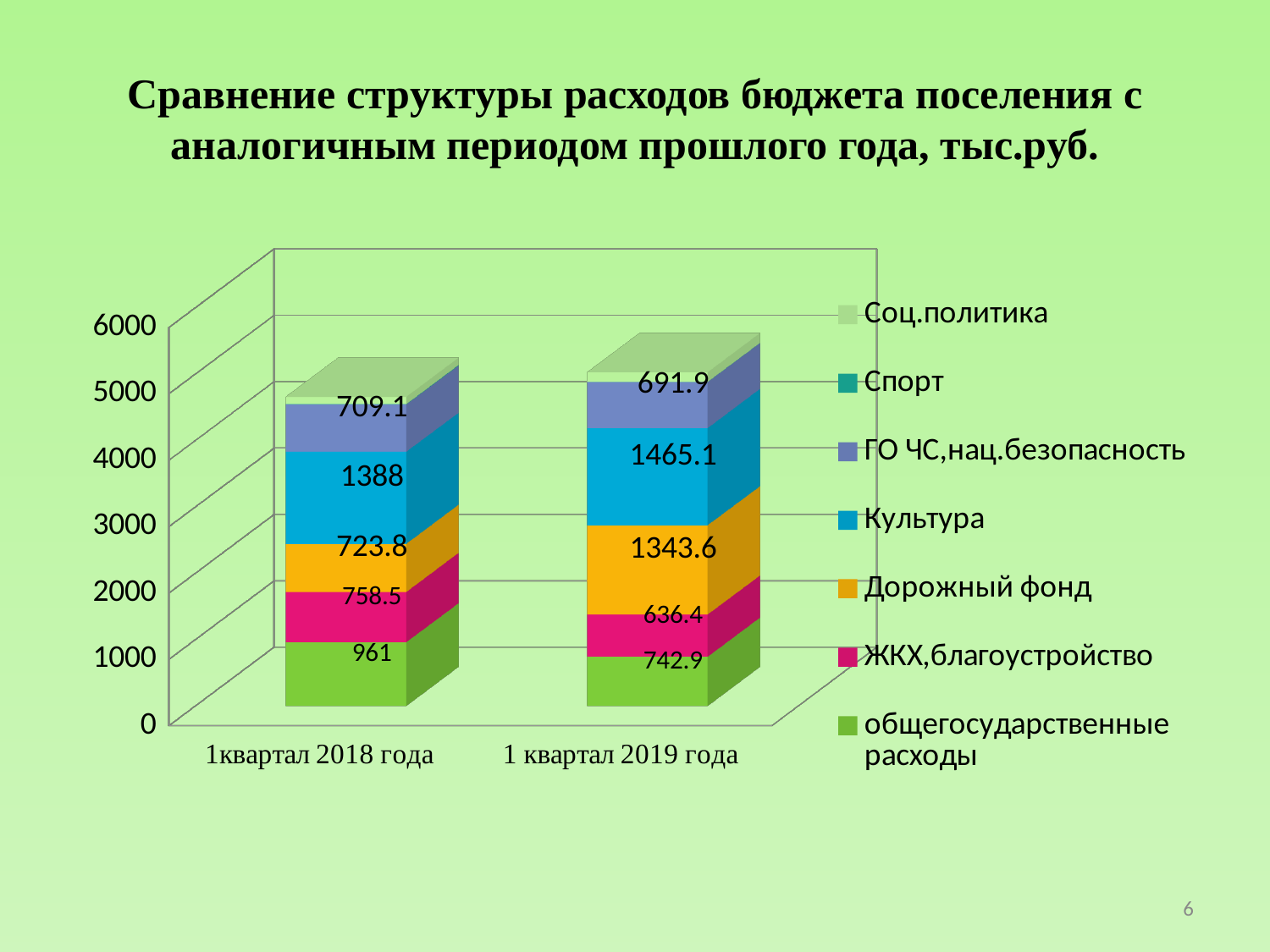
How many categories are shown on the x axis? 2 What is the difference between the Культура values for 1 квартал 2019 года and 1квартал 2018 года? 77.1 What is the value for Культура in 1 квартал 2019 года? 1465.1 How many series does the legend list? 7 Which labeled series has the highest value in 1квартал 2018 года? Культура What type of chart is shown on the slide? stacked bar chart What is the value for общегосударственные расходы in 1 квартал 2019 года? 742.9 What is the difference between the Дорожный фонд values for 1 квартал 2019 года and 1квартал 2018 года? 619.8 Which is larger: общегосударственные расходы in 1квартал 2018 года or in 1 квартал 2019 года? 1квартал 2018 года What is the value for Дорожный фонд in 1квартал 2018 года? 723.8 What is the value for ЖКХ,благоустройство in 1квартал 2018 года? 758.5 What is the value for ГО ЧС,нац.безопасность in 1 квартал 2019 года? 691.9